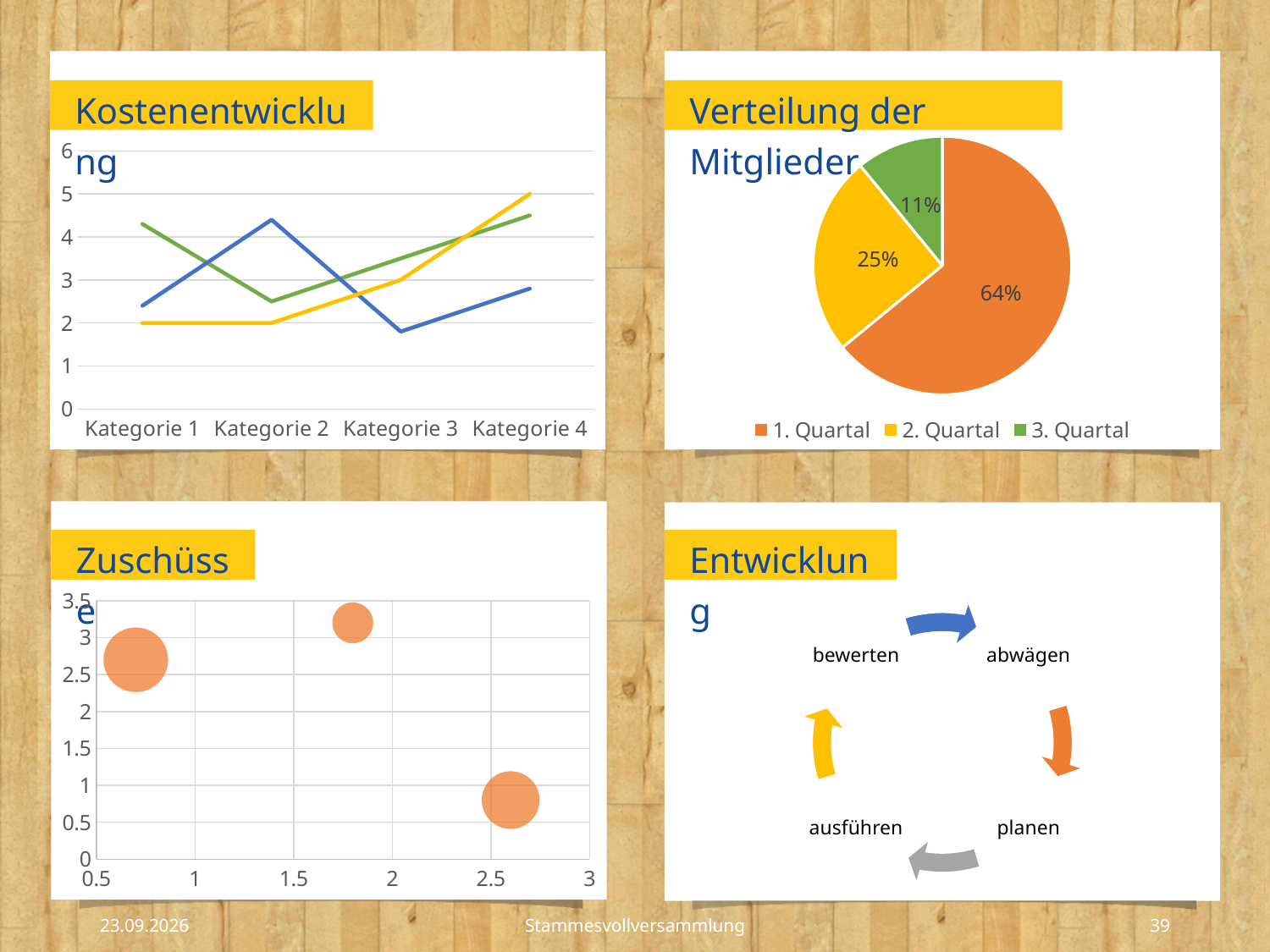
How many categories are shown on the x axis of the 'Kostenentwicklung' chart? 4 How many entries does the legend of the 'Verteilung der Mitglieder' pie chart list? 3 In the 'Verteilung der Mitglieder' pie chart, which slice is the smallest? 3. Quartal What kind of chart is the 'Kostenentwicklung' chart at the top left of the slide? line chart What kind of chart is the 'Verteilung der Mitglieder' chart at the top right of the slide? pie chart In the 'Kostenentwicklung' chart, is the value of the yellow line at Kategorie 4 greater or less than 4? greater In the 'Verteilung der Mitglieder' pie chart, what share does 1. Quartal have? 64% In the 'Kostenentwicklung' chart, does the yellow line rise or fall from Kategorie 2 to Kategorie 4? rise In the 'Verteilung der Mitglieder' pie chart, what is the difference between the shares of 1. Quartal and 2. Quartal? 39% In the 'Kostenentwicklung' chart, is the value of the blue line at Kategorie 3 greater or less than 3? less In the 'Verteilung der Mitglieder' pie chart, what share does 3. Quartal have? 11% How many bubbles are plotted in the 'Zuschüsse' chart at the bottom left of the slide? 3